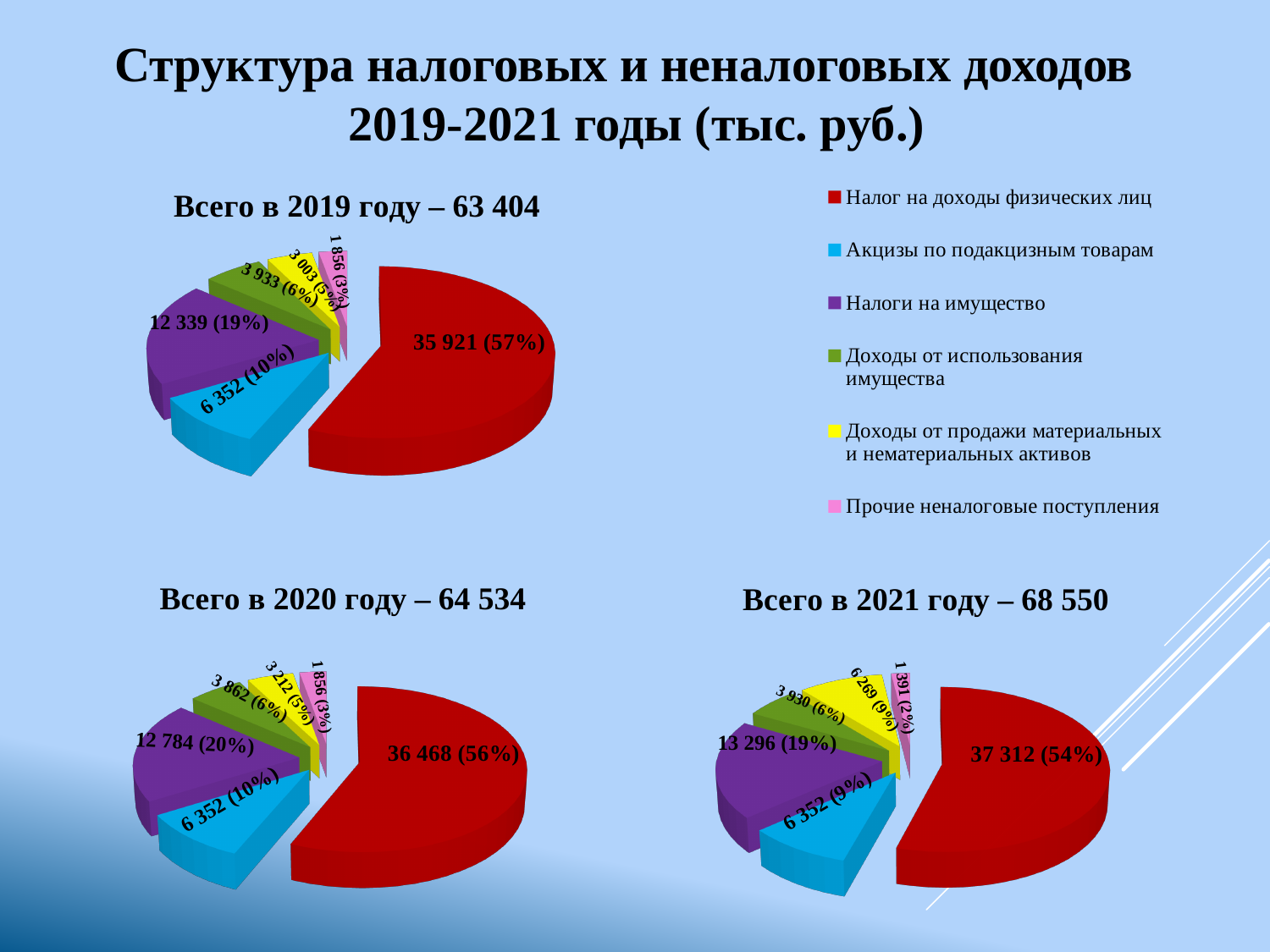
On the chart 'Всего в 2019 году – 63 404', what share of the pie does 'Налоги на имущество' take? 19% On the chart 'Всего в 2020 году – 64 534', which category has the largest slice? Налог на доходы физических лиц How many categories does the legend list? 6 On the chart 'Всего в 2021 году – 68 550', what is the value for 'Налоги на имущество'? 13 296 (19%) On the chart 'Всего в 2021 году – 68 550', what share of the pie does 'Акцизы по подакцизным товарам' take? 9% On the chart 'Всего в 2019 году – 63 404', what is the value for 'Налог на доходы физических лиц'? 35 921 (57%) On the chart 'Всего в 2020 году – 64 534', what is the value for 'Доходы от продажи материальных и нематериальных активов'? 3 212 (5%) On the chart 'Всего в 2020 году – 64 534', what is the difference between 'Налоги на имущество' and 'Акцизы по подакцизным товарам'? 6 432 On the chart 'Всего в 2021 году – 68 550', which category has the smallest slice? Прочие неналоговые поступления What kind of chart is used on this slide? Pie chart On the chart 'Всего в 2021 году – 68 550', which is larger: 'Доходы от использования имущества' or 'Доходы от продажи материальных и нематериальных активов'? Доходы от продажи материальных и нематериальных активов Which colour represents 'Акцизы по подакцизным товарам' in the legend? Blue